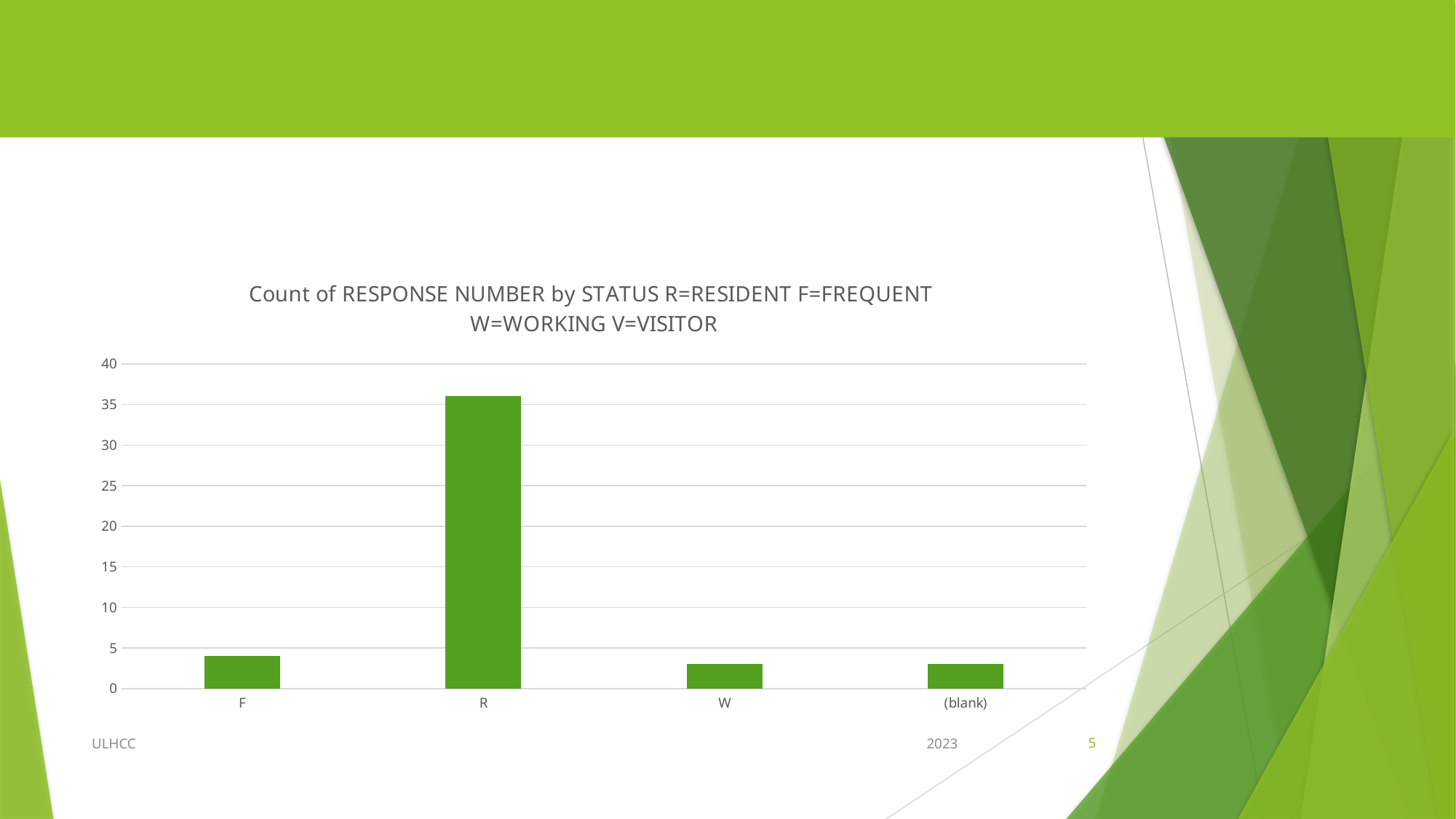
What kind of chart is shown on the slide? bar chart Is the value for R greater or less than 30? greater Which is larger, the value for R or the value for F? R Which is larger, the value for W or the value for R? R What is the highest value shown on the y axis of the chart? 40 Is the value for F greater or less than 5? less Is the value for W greater or less than 5? less Which category has the highest count of response number? R What is the title of the chart? Count of RESPONSE NUMBER by STATUS R=RESIDENT F=FREQUENT W=WORKING V=VISITOR How many categories are shown on the x axis of the chart? 4